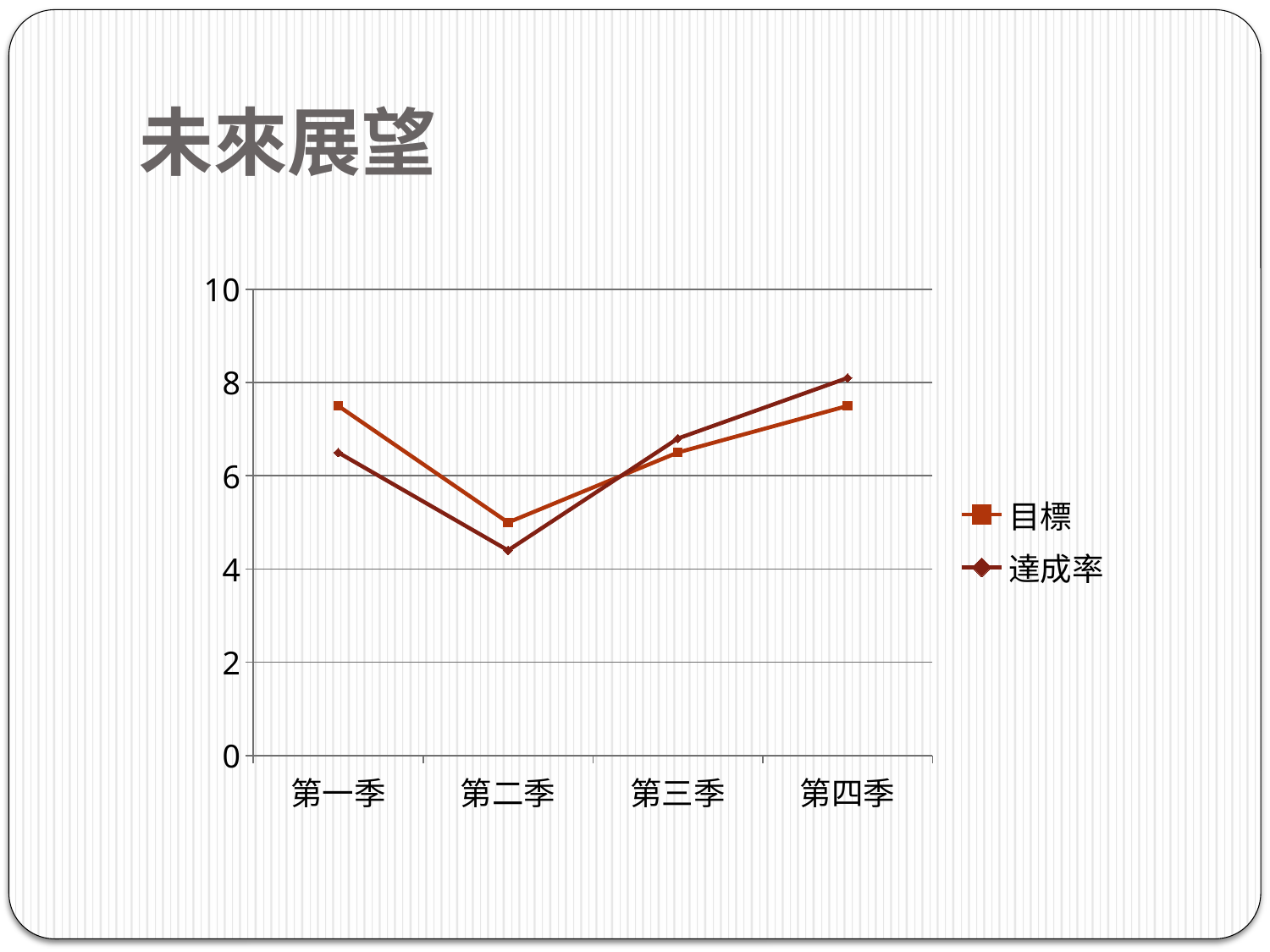
Which category has the highest value for 達成率? 第四季 What kind of chart is shown on the slide? line chart How many categories are shown on the x axis? 4 Is the value for 目標 in 第二季 greater or less than 6? less Which category has the lowest value for 達成率? 第二季 In 第一季, which series has the larger value, 目標 or 達成率? 目標 Does the 達成率 line rise or fall from 第二季 to 第四季? rise Which category has the lowest value for 目標? 第二季 In 第四季, which series has the larger value, 目標 or 達成率? 達成率 Is the value for 目標 in 第一季 greater or less than 6? greater How many series does the legend list? 2 Is the value for 達成率 in 第二季 greater or less than 6? less